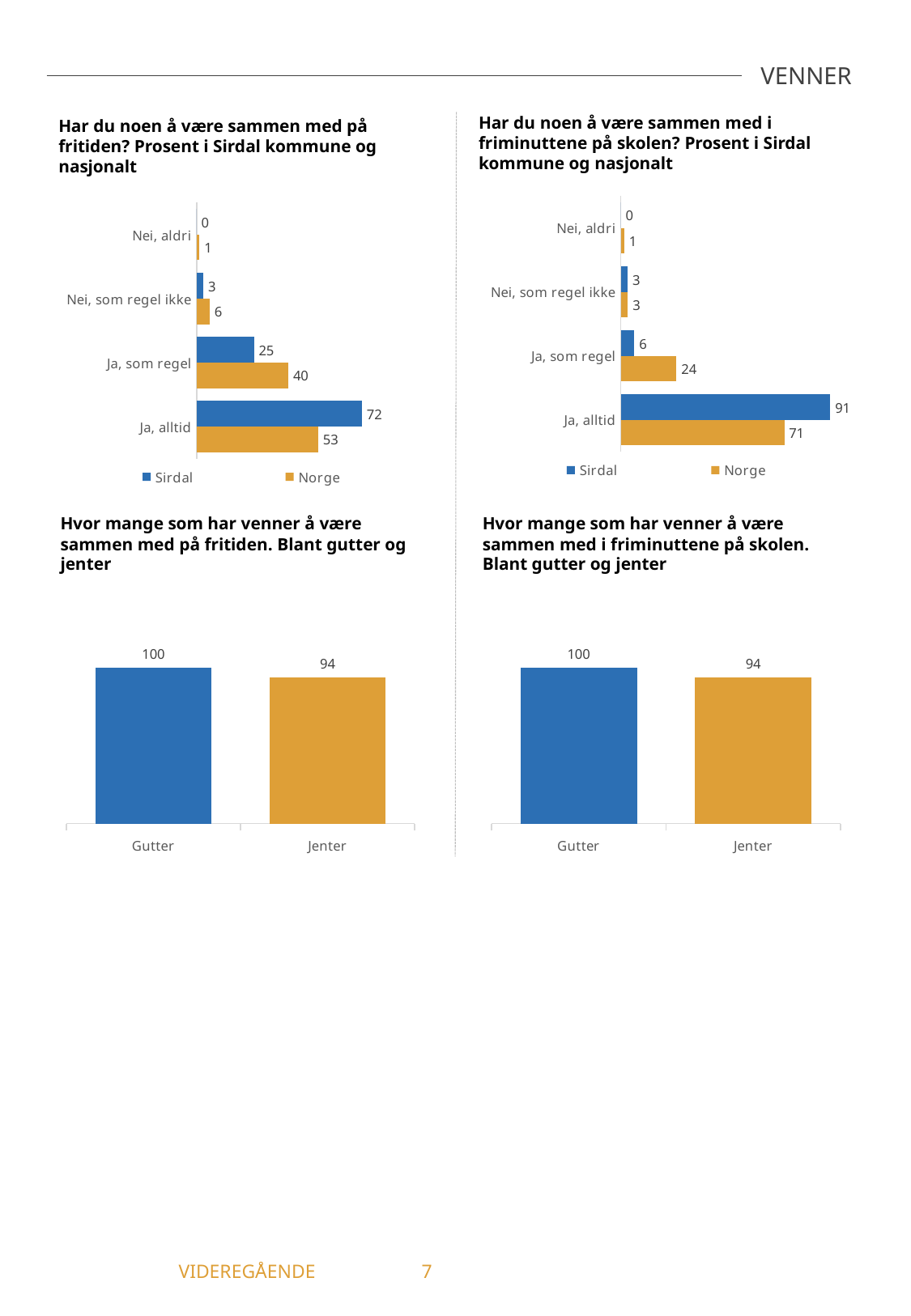
In the top-left chart 'Har du noen å være sammen med på fritiden?', what is the value for Sirdal for 'Ja, alltid'? 72 In the bottom-right chart 'Hvor mange som har venner å være sammen med i friminuttene på skolen', what is the difference between Gutter and Jenter? 6 In the top-right chart 'Har du noen å være sammen med i friminuttene på skolen?', what is the value for Sirdal for 'Ja, alltid'? 91 In the top-right chart 'Har du noen å være sammen med i friminuttene på skolen?', how many categories are shown? 4 What kind of chart is the bottom-left chart 'Hvor mange som har venner å være sammen med på fritiden'? bar chart In the top-left chart 'Har du noen å være sammen med på fritiden?', what is the value for Norge for 'Ja, som regel'? 40 In the top-right chart 'Har du noen å være sammen med i friminuttene på skolen?', what is the value for Norge for 'Ja, som regel'? 24 In the top-right chart 'Har du noen å være sammen med i friminuttene på skolen?', which category has the highest Sirdal value? Ja, alltid In the bottom-left chart 'Hvor mange som har venner å være sammen med på fritiden', what is the value for Jenter? 94 In the top-left chart 'Har du noen å være sammen med på fritiden?', what is the difference between Sirdal and Norge for 'Ja, alltid'? 19 In the top-right chart 'Har du noen å være sammen med i friminuttene på skolen?', is the Sirdal value for 'Ja, som regel' larger or smaller than the Norge value? smaller In the top-left chart 'Har du noen å være sammen med på fritiden?', how many series does the legend list? 2